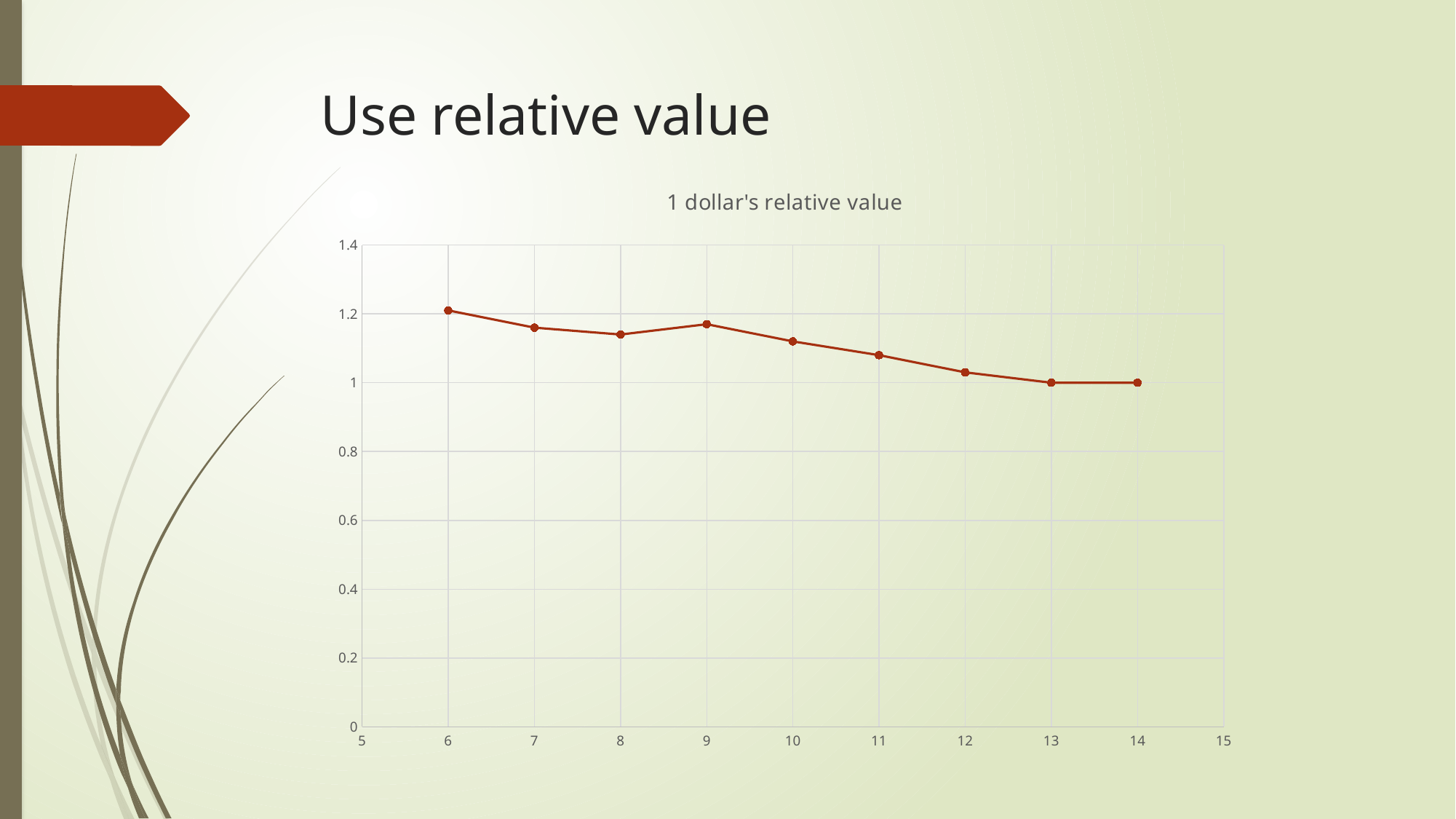
Is the value at x = 10 greater or less than 1.2? less Is the value at x = 8 greater or less than 1.2? less Which has the larger value, x = 6 or x = 10? 6 What kind of chart is shown on the slide? line chart How many data points are plotted on the line? 9 At which x value is the relative value highest? 6 Overall, do the values rise or fall as x increases from 6 to 14? fall What is the title of the chart? 1 dollar's relative value Which has the larger value, x = 8 or x = 11? 8 Is the value at x = 6 greater or less than 1? greater What is the relative value at x = 13? 1